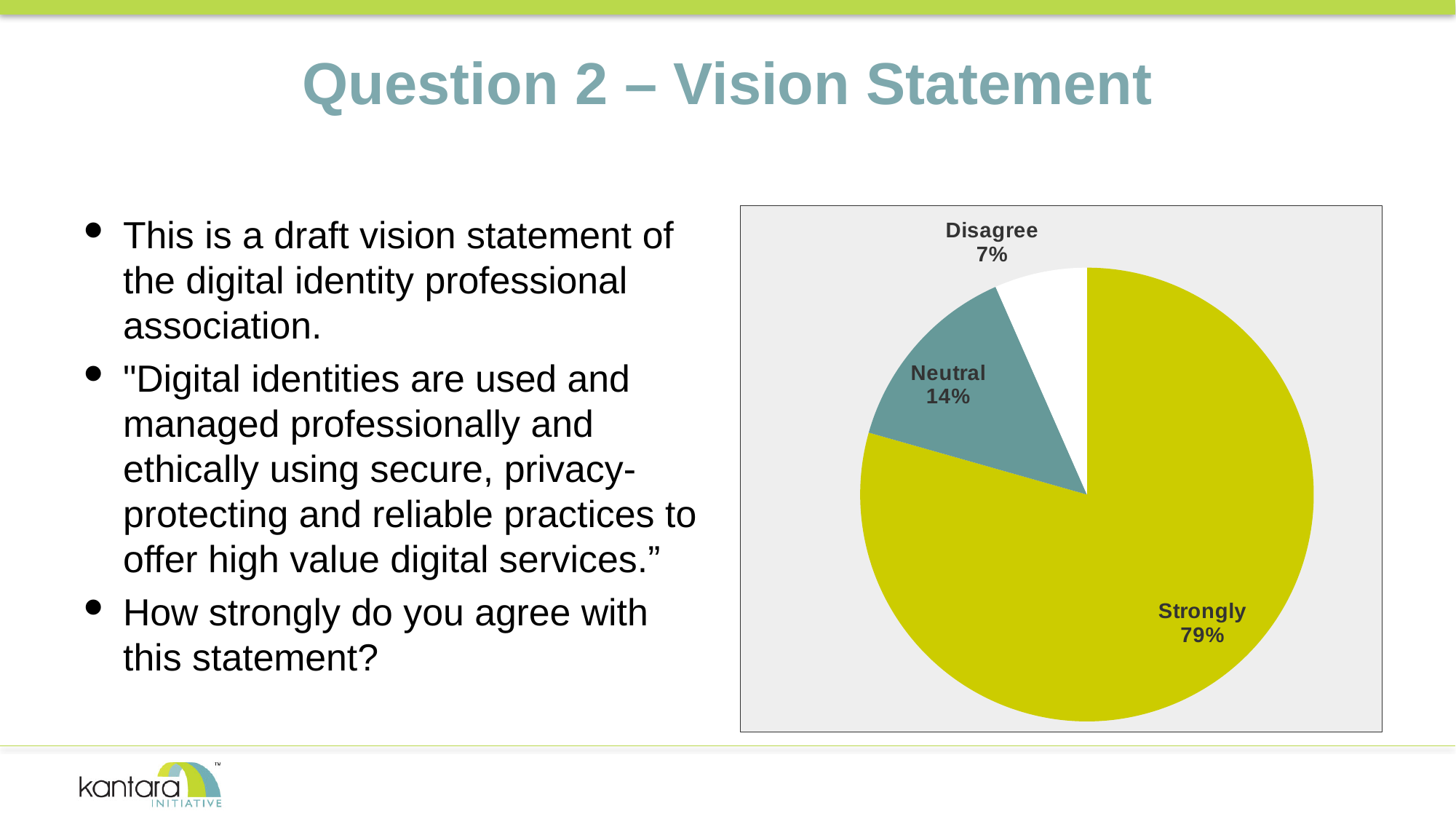
Which response category has the largest share of the pie? Strongly What is the difference in percentage points between the Neutral and Disagree slices? 7 What percentage of respondents answered Neutral? 14% What share of the pie does the Strongly slice represent? 79% What kind of chart is shown on the slide? Pie chart What is the difference in percentage points between the Strongly and Neutral slices? 65 How many slices does the pie chart have? 3 What percentage of respondents answered Strongly? 79% Which response category has the smallest share of the pie? Disagree Which slice is larger, Neutral or Disagree? Neutral What colour is the Neutral slice of the pie chart? Teal What percentage of respondents answered Disagree? 7%